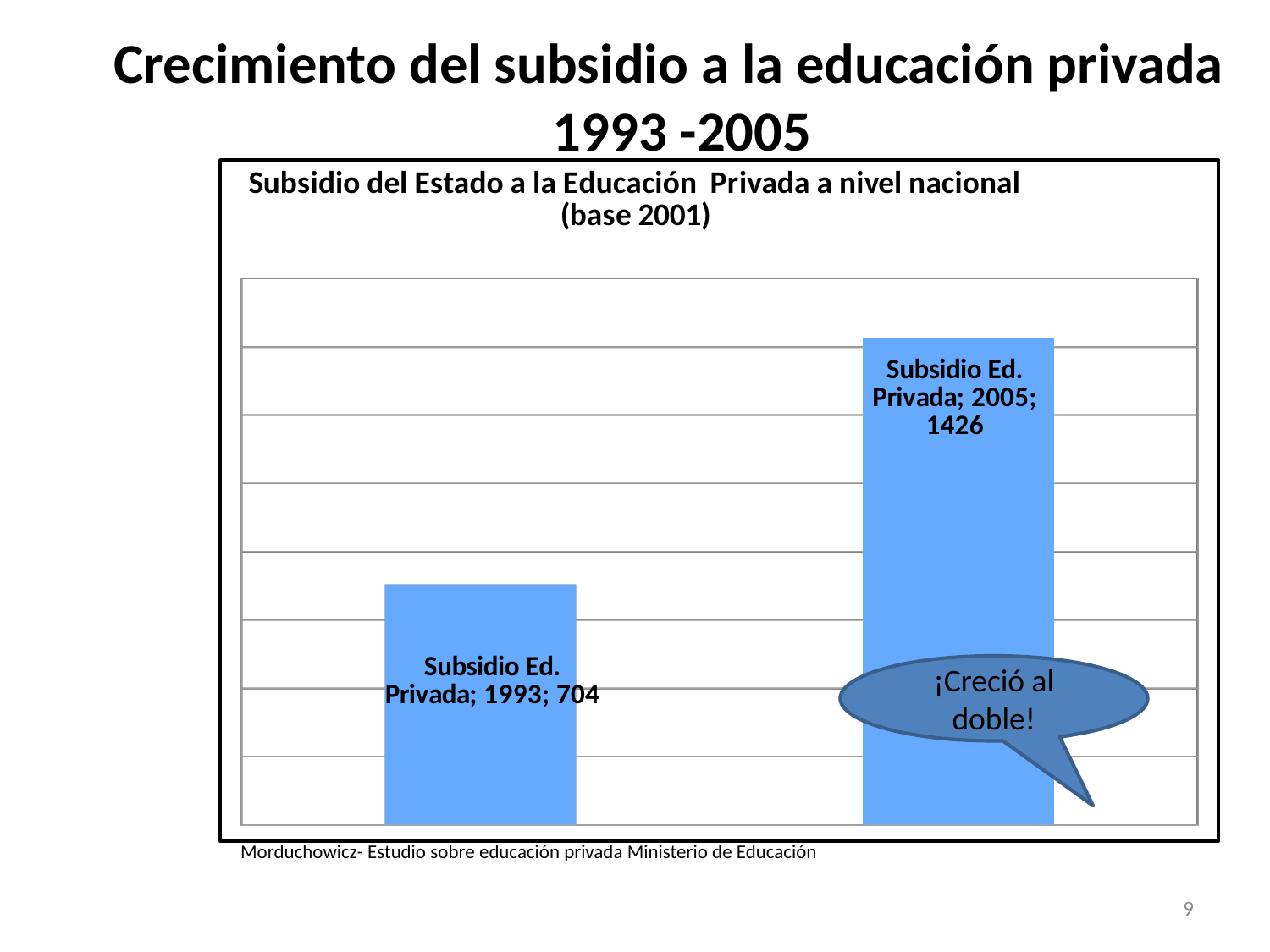
What is the value for Subsidio Ed. Privada in 1993? 704 Is the value for 1993 larger or smaller than the value for 2005? smaller How many bars are plotted in the chart? 2 Which year has the higher subsidy value, 1993 or 2005? 2005 Do the values rise or fall from 1993 to 2005? rise What kind of chart is shown on the slide? bar chart What does the callout on the chart say? ¡Creció al doble! What is the title of the chart? Subsidio del Estado a la Educación Privada a nivel nacional (base 2001) Which year has the lower subsidy value? 1993 What is the difference between the 2005 value and the 1993 value? 722 What is the value for Subsidio Ed. Privada in 2005? 1426